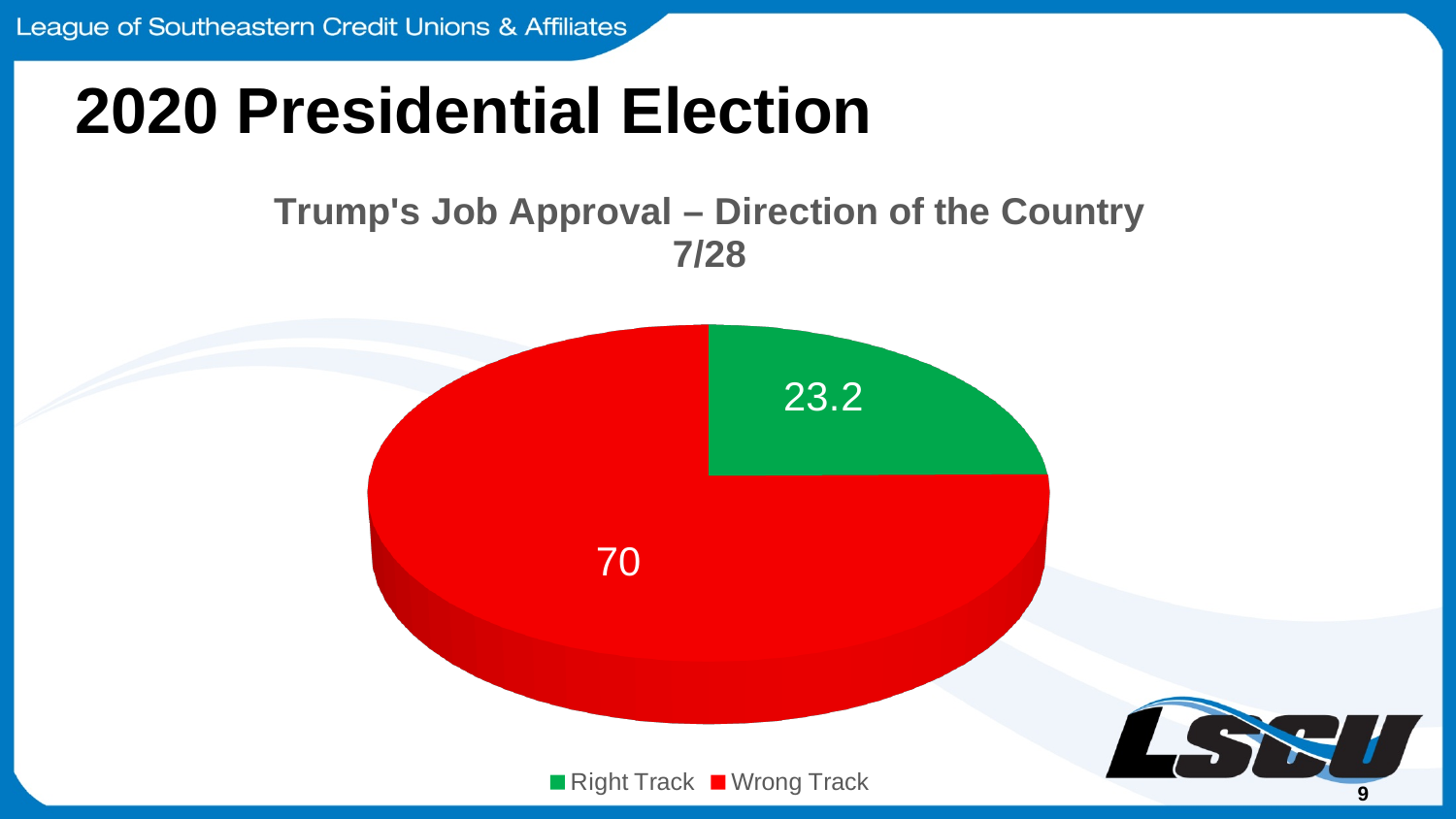
What is the difference between the Wrong Track value and the Right Track value? 46.8 How many slices does the pie chart have? 2 Which category has the largest slice of the pie? Wrong Track What type of chart is shown on the slide? Pie chart What is the value shown for Right Track? 23.2 Which category has the smallest slice of the pie? Right Track What is the value shown for Wrong Track? 70 Which is larger, the value for Right Track or the value for Wrong Track? Wrong Track What colour is the Wrong Track slice? Red How many entries does the legend list? 2 What is the title of the chart? Trump's Job Approval – Direction of the Country 7/28